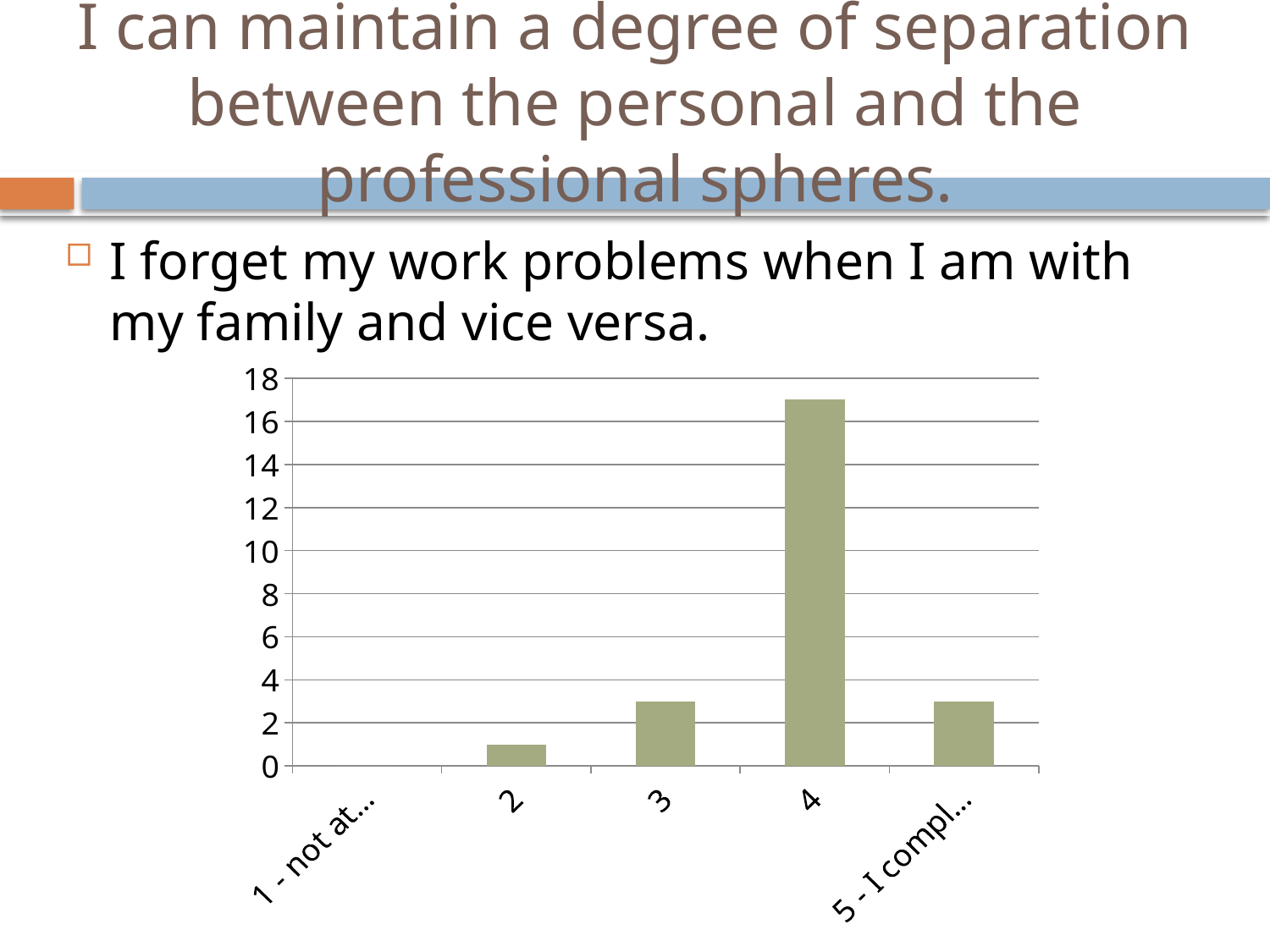
Which category has the highest bar in the chart? 4 Is the value for category 2 greater or less than 2? less Is the value for category 3 greater or less than 4? less Which is larger, the value for category 3 or the value for category 2? 3 What kind of chart is shown on the slide? bar chart Is the value for category 4 greater or less than 16? greater How many categories are shown on the x axis of the chart? 5 Which is larger, the value for category 4 or the value for category 3? 4 Which category has the lowest value in the chart? 1 - not at... What is the highest value shown on the y axis of the chart? 18